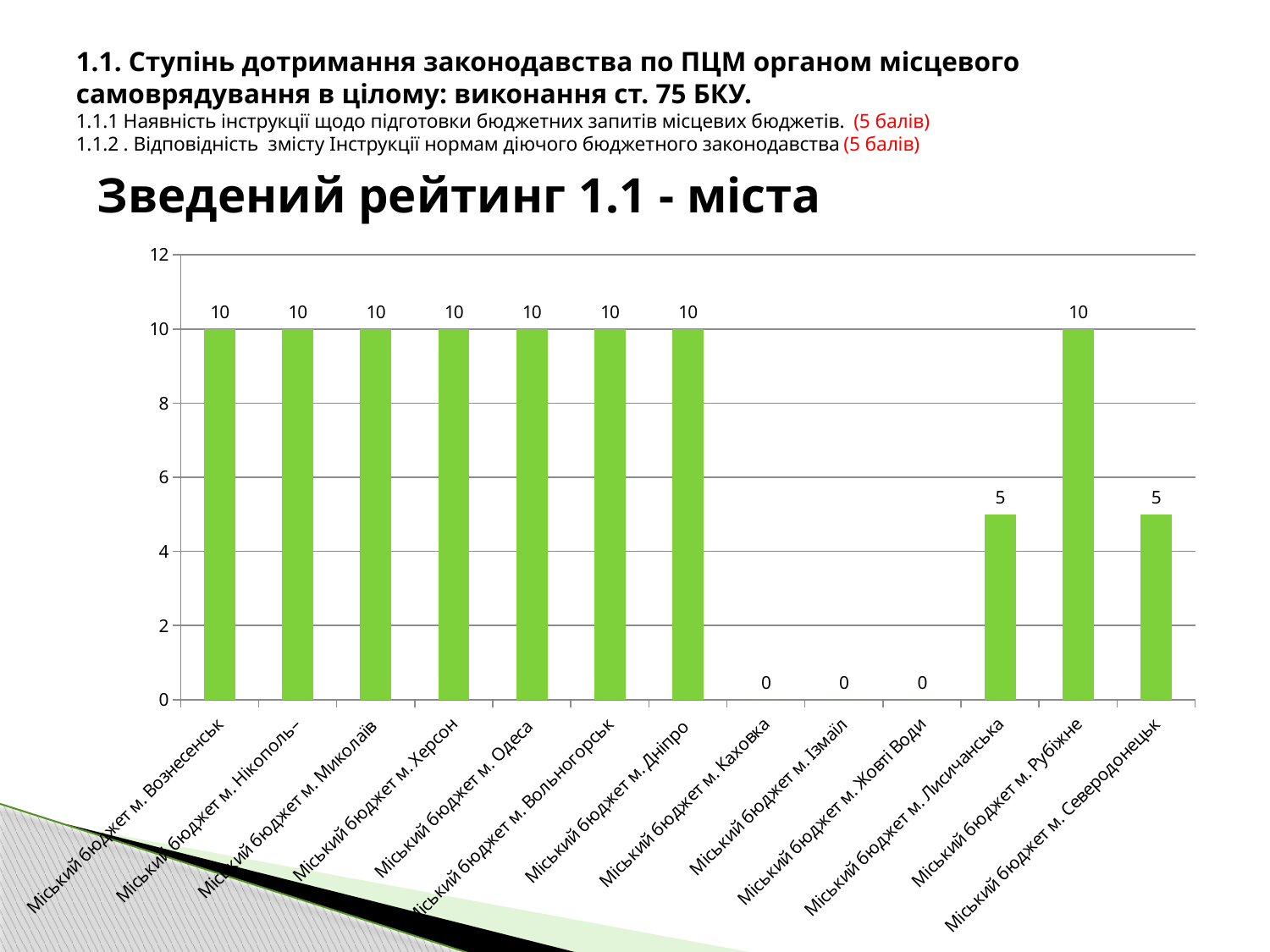
What is the value for Міський бюджет м. Дніпро? 10 Which is larger, the value for Міський бюджет м. Херсон or the value for Міський бюджет м. Северодонецьк? Міський бюджет м. Херсон What is the value for Міський бюджет м. Лисичанська? 5 How many categories are shown on the x axis? 13 What is the difference between the values for Міський бюджет м. Одеса and Міський бюджет м. Лисичанська? 5 How many categories have a value of 0? 3 What is the value for Міський бюджет м. Каховка? 0 What is the value for Міський бюджет м. Рубіжне? 10 What kind of chart is shown on the slide? bar chart Is the value for Міський бюджет м. Ізмаїл greater or less than 2? less What is the title of the chart? Зведений рейтинг 1.1 - міста What is the value for Міський бюджет м. Северодонецьк? 5